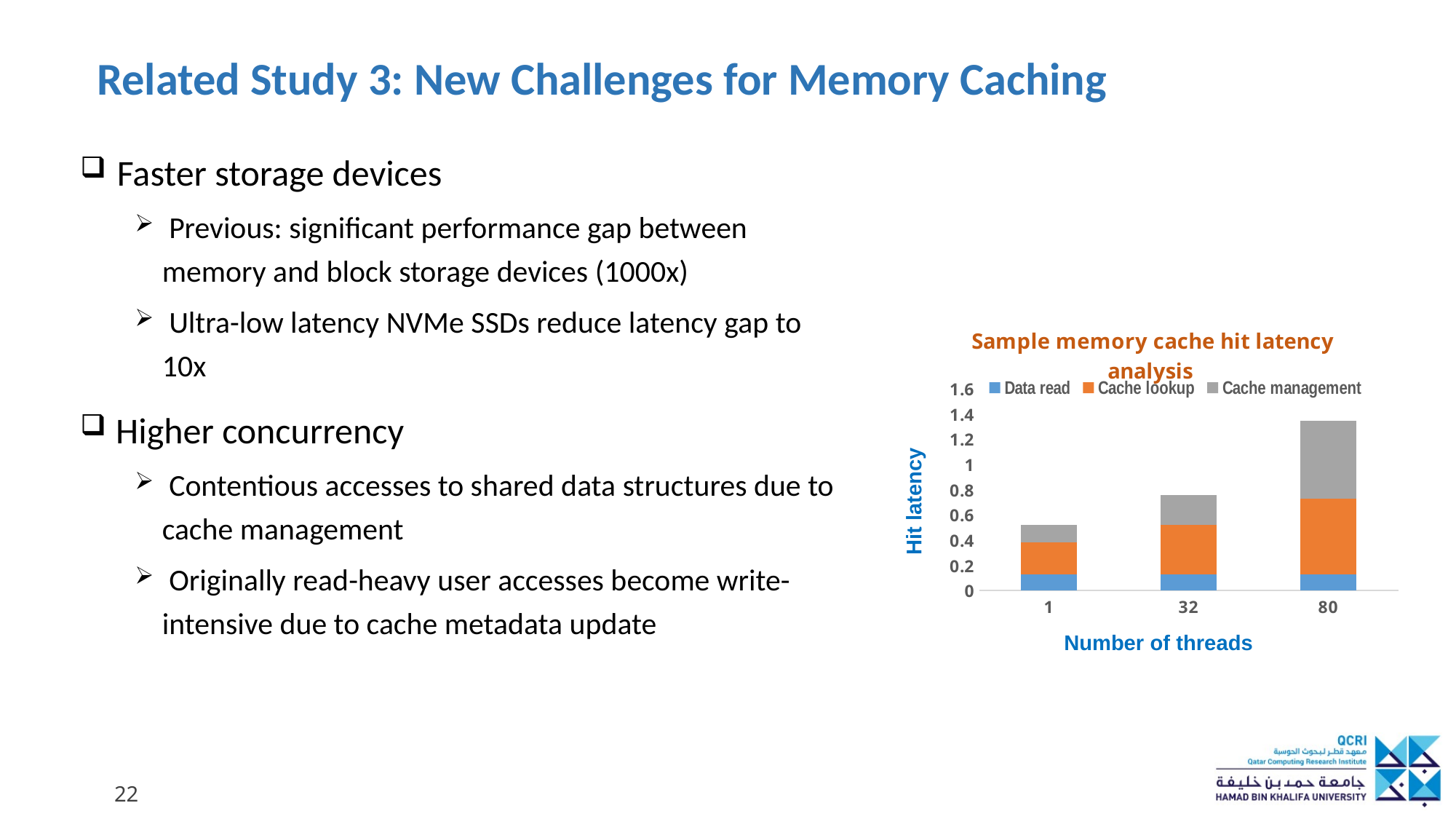
What kind of chart is shown on the slide? Stacked bar chart What is the label of the x axis? Number of threads What is the title of the chart? Sample memory cache hit latency analysis Is the total hit latency for 80 threads greater or less than 1? greater Which number of threads has the lowest total hit latency? 1 Is the total hit latency for 1 thread greater or less than 0.6? less Which number of threads has the highest total hit latency? 80 Does the total hit latency rise or fall as the number of threads increases? Rises How many series does the chart legend list? 3 Is the total hit latency for 32 threads greater or less than 0.6? greater Which is larger: the Cache management portion for 80 threads or for 1 thread? 80 threads How many thread-count categories are shown on the x axis? 3